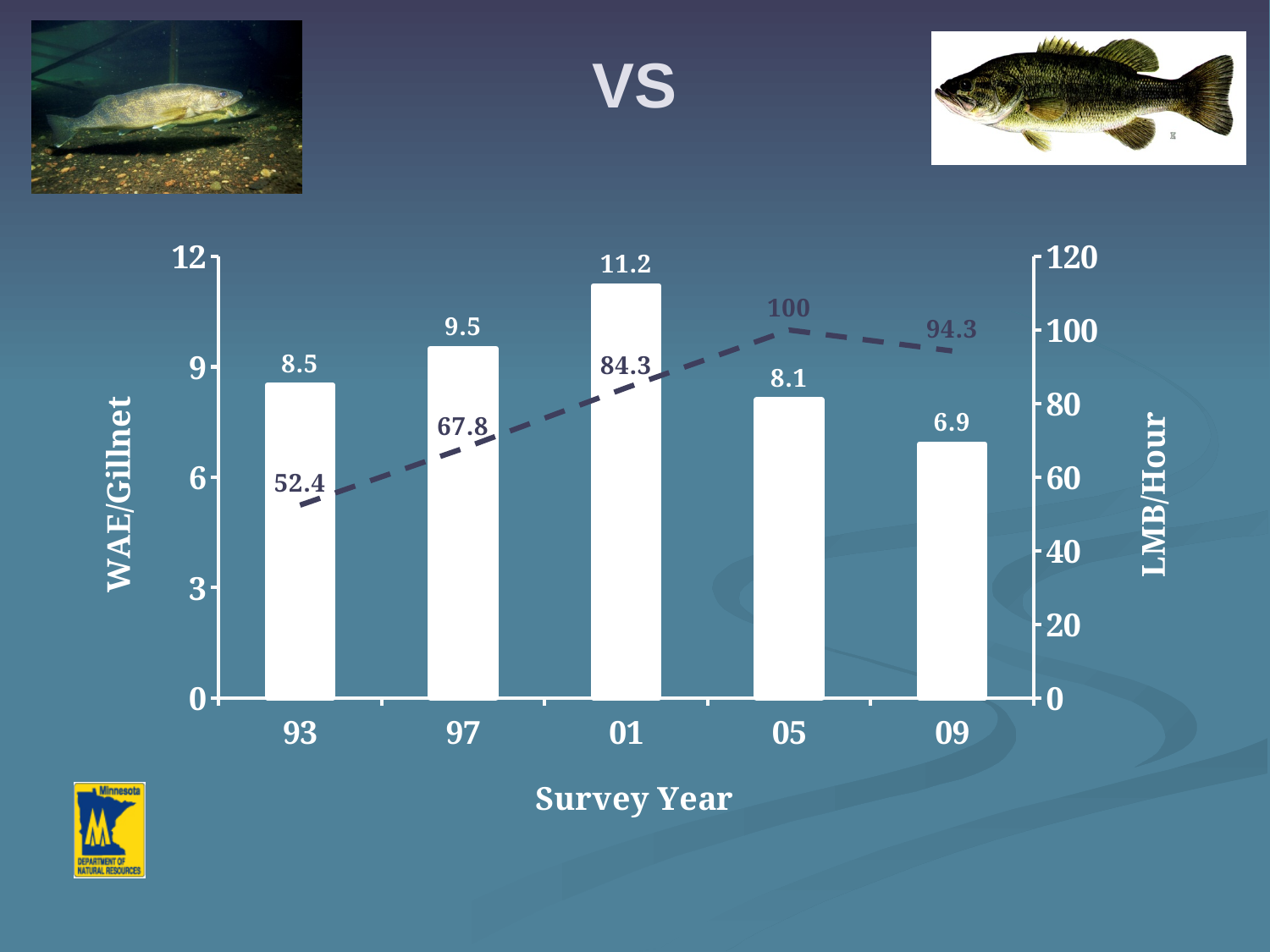
What is the WAE/Gillnet value for survey year 01? 11.2 How many survey years are shown on the x axis? 5 Which survey year has the lowest LMB/Hour value? 93 What is the difference between the LMB/Hour values for survey years 05 and 09? 5.7 Which is larger, the WAE/Gillnet value for 97 or for 05? 97 Which survey year has the highest WAE/Gillnet value? 01 What is the LMB/Hour value for survey year 93? 52.4 Which survey year has the lowest WAE/Gillnet value? 09 What is the title of the x axis? Survey Year Does the LMB/Hour line rise or fall from survey year 93 to 05? rise What is the LMB/Hour value for survey year 05? 100 What is the difference between the WAE/Gillnet values for survey years 01 and 09? 4.3